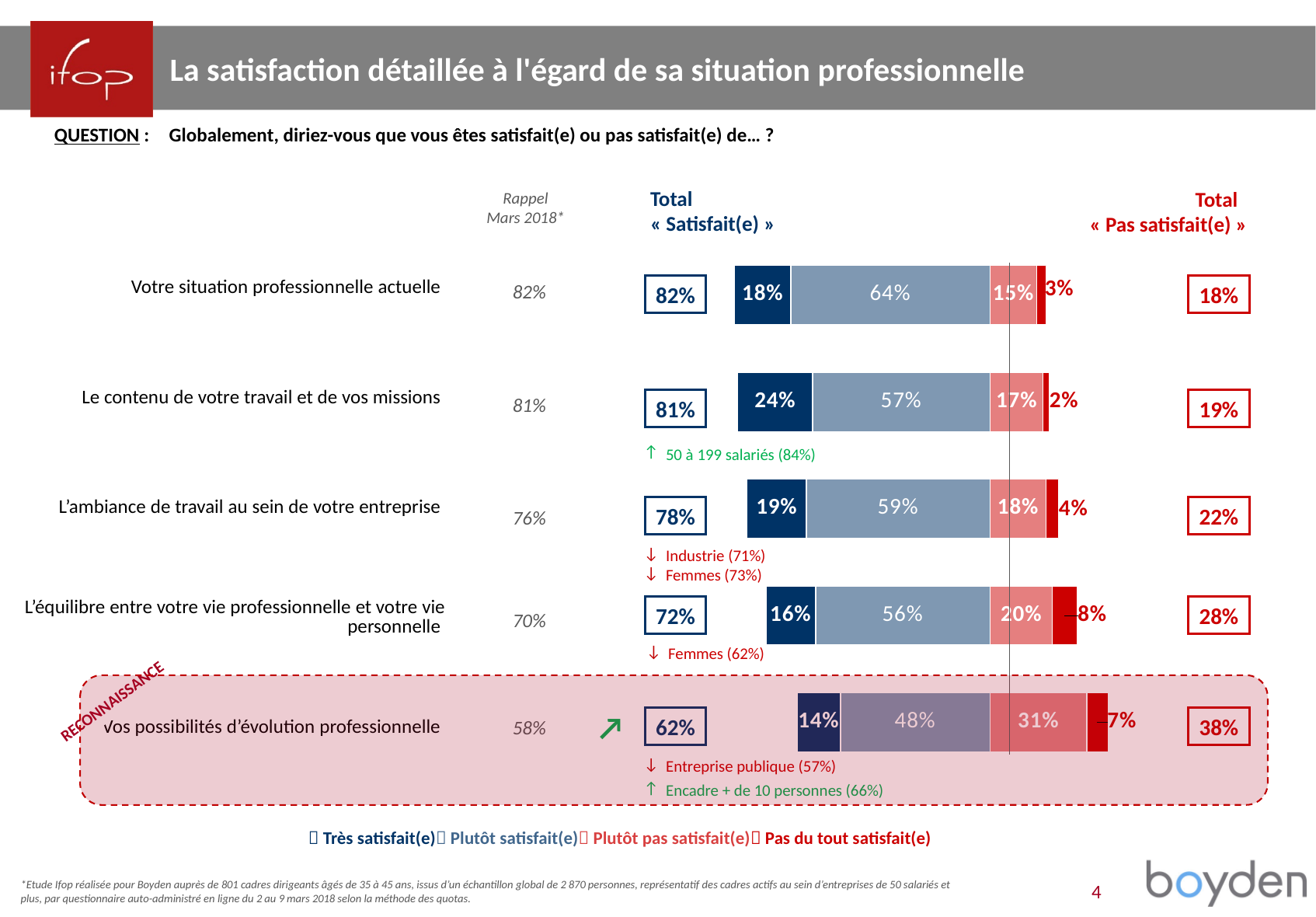
What is the "Plutôt pas satisfait(e)" value for "Vos possibilités d'évolution professionnelle"? 31% Which is larger: the "Plutôt pas satisfait(e)" value for "L'ambiance de travail au sein de votre entreprise" or for "L'équilibre entre votre vie professionnelle et votre vie personnelle"? L'équilibre entre votre vie professionnelle et votre vie personnelle Which item has the lowest Total « Satisfait(e) » value? Vos possibilités d'évolution professionnelle Which item has the highest "Très satisfait(e)" value? Le contenu de votre travail et de vos missions What type of chart is shown on the slide? Stacked bar chart What is the "Plutôt satisfait(e)" value for "Votre situation professionnelle actuelle"? 64% What is the Rappel Mars 2018 value shown for "L'ambiance de travail au sein de votre entreprise"? 76% How many items (categories) are plotted in the chart? 5 What is the "Très satisfait(e)" value for "Le contenu de votre travail et de vos missions"? 24% What is the "Pas du tout satisfait(e)" value for "L'équilibre entre votre vie professionnelle et votre vie personnelle"? 8% How many series does the legend list? 4 What is the difference between the Total « Satisfait(e) » for "Votre situation professionnelle actuelle" and for "Vos possibilités d'évolution professionnelle"? 20 percentage points